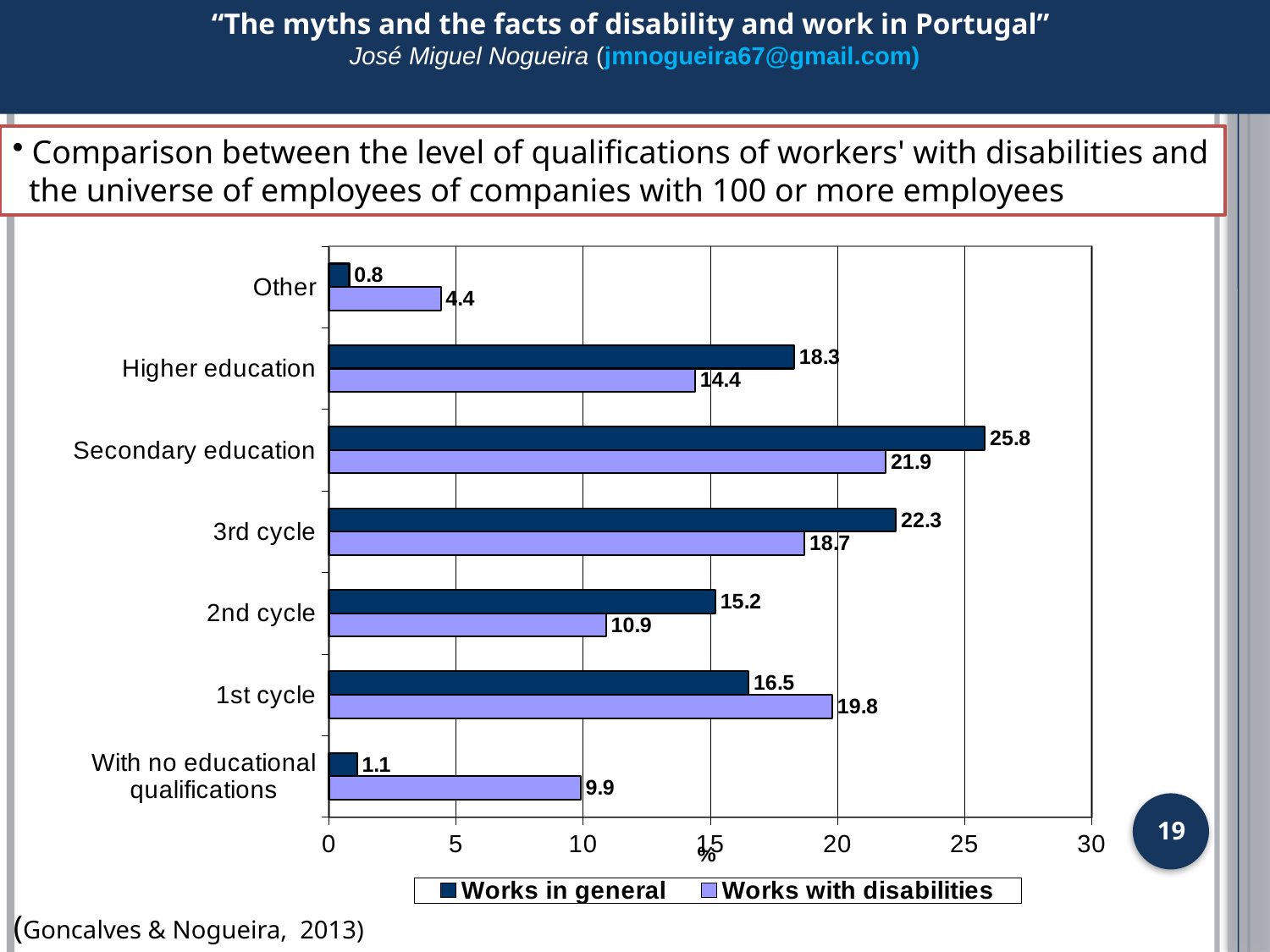
What label is shown on the horizontal axis of the chart? % What is the value for Secondary education in the Works in general series? 25.8 Which category has the lowest value in the Works with disabilities series? Other How many categories are shown on the chart? 7 What is the difference between the Works in general and Works with disabilities values for Higher education? 3.9 How many series does the legend list? 2 What is the value for 1st cycle in the Works with disabilities series? 19.8 What kind of chart is shown on the slide? Bar chart For 1st cycle, which series has the larger value: Works in general or Works with disabilities? Works with disabilities Which category has the highest value in the Works in general series? Secondary education What is the value for With no educational qualifications in the Works with disabilities series? 9.9 What is the value for 2nd cycle in the Works in general series? 15.2